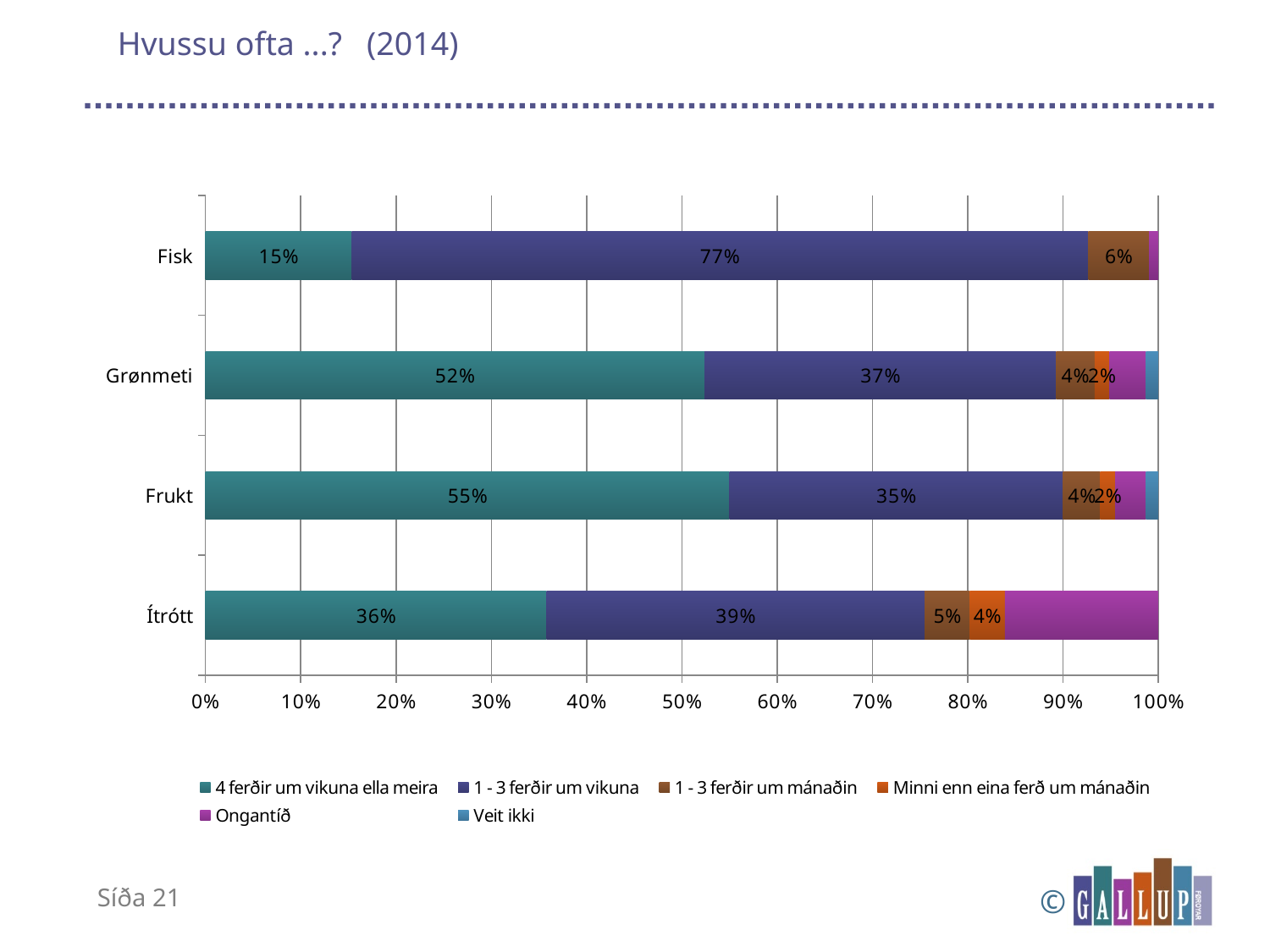
Is the 'Ongantíð' value for Ítrótt greater or less than 10%? greater Which category has the lowest value for '4 ferðir um vikuna ella meira'? Fisk What is the value for '1 - 3 ferðir um mánaðin' in the Ítrótt bar? 5% In the Ítrótt bar, which is larger: '4 ferðir um vikuna ella meira' or '1 - 3 ferðir um vikuna'? 1 - 3 ferðir um vikuna What is the value for '1 - 3 ferðir um vikuna' in the Fisk bar? 77% What is the difference between the '4 ferðir um vikuna ella meira' values for Frukt and Grønmeti? 3 percentage points How many series does the legend list? 6 Which category has the highest value for '1 - 3 ferðir um vikuna'? Fisk How many categories are plotted on the chart? 4 What kind of chart is shown on the slide? Stacked bar chart Which category has the highest value for '4 ferðir um vikuna ella meira'? Frukt What is the value for '4 ferðir um vikuna ella meira' in the Frukt bar? 55%